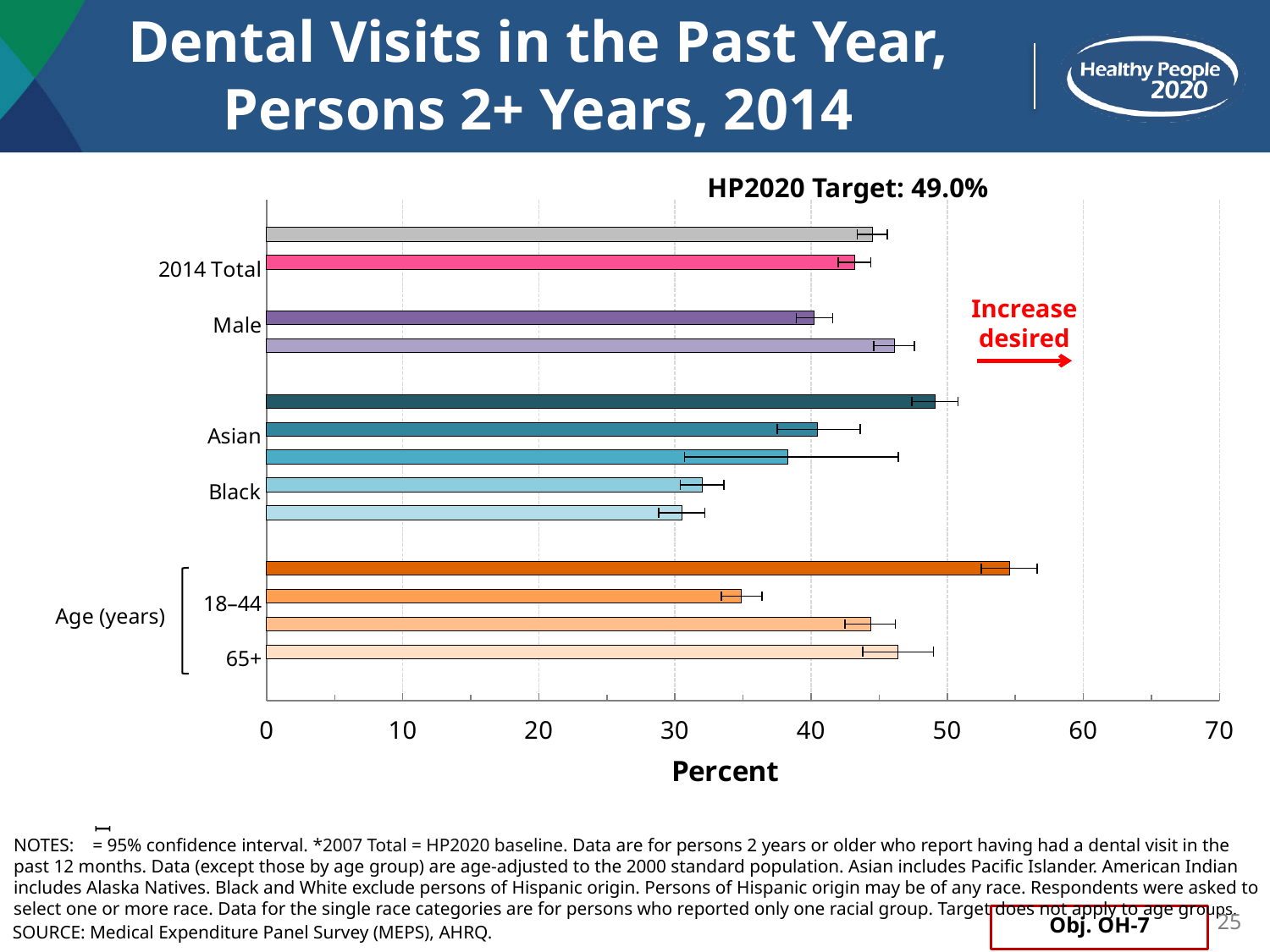
Is the value for 18–44 greater or less than 40? less What is the HP2020 Target value shown on the chart? 49.0% What type of chart is shown on the slide? bar chart Which has the larger value, Male or Black? Male What is the title of the x axis? Percent Is the value for 2014 Total greater or less than 50? less Is the value for 65+ greater or less than 40? greater Which has the larger value, 2014 Total or Black? 2014 Total Which has the larger value, 65+ or 18–44? 65+